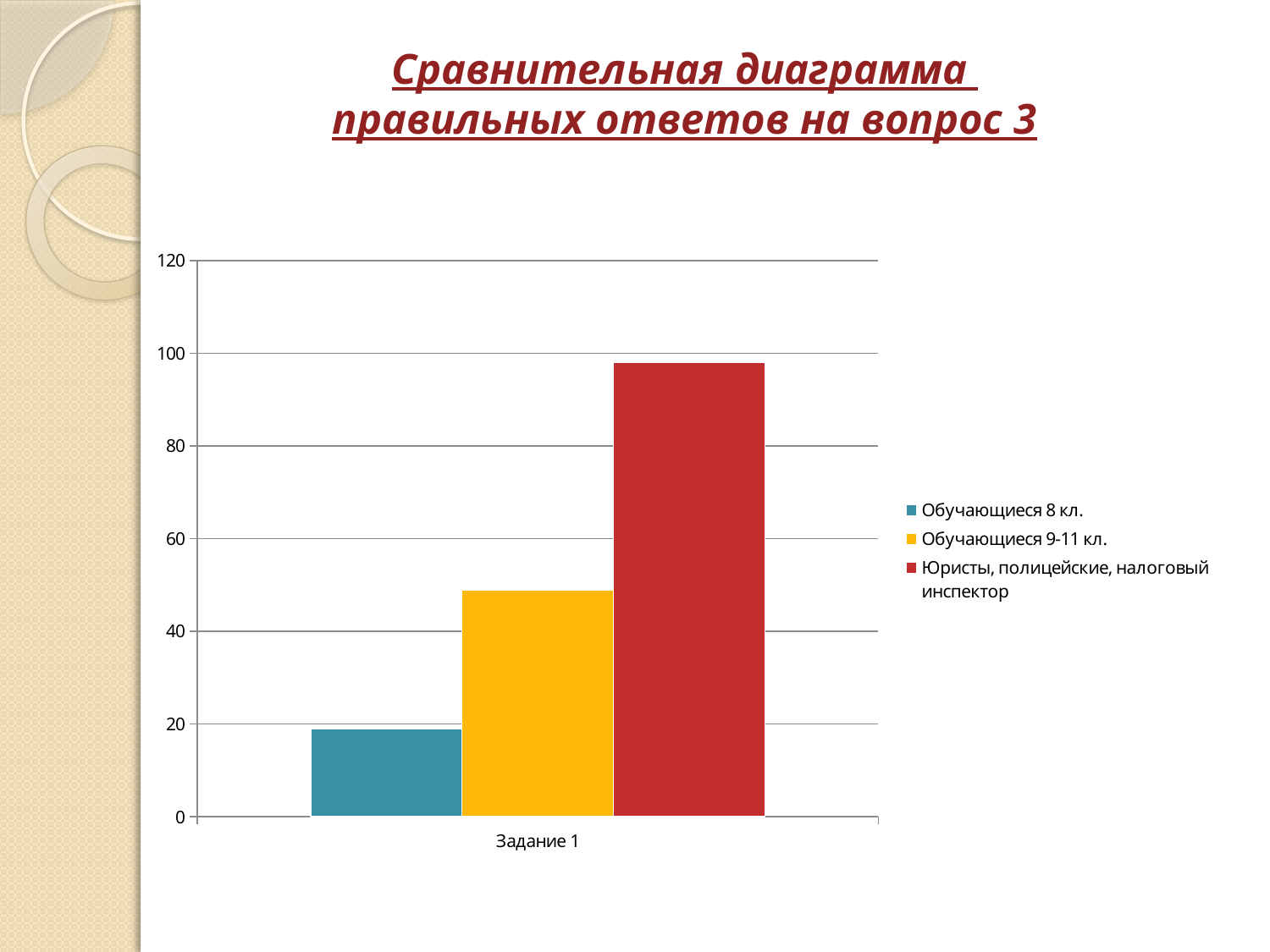
Is the value for Обучающиеся 9-11 кл. greater or less than 60? less Which series has the highest bar for Задание 1? Юристы, полицейские, налоговый инспектор Which series is shown in red? Юристы, полицейские, налоговый инспектор How many categories are shown on the x axis? 1 How many series does the legend list? 3 Which series has the lowest bar for Задание 1? Обучающиеся 8 кл. Is the value for Обучающиеся 9-11 кл. greater or less than 40? greater Which is larger for Задание 1: the value for Обучающиеся 9-11 кл. or for Обучающиеся 8 кл.? Обучающиеся 9-11 кл. What is the title of the chart on the slide? Сравнительная диаграмма правильных ответов на вопрос 3 Is the value for Юристы, полицейские, налоговый инспектор greater or less than 80? greater What kind of chart is shown on the slide? bar chart